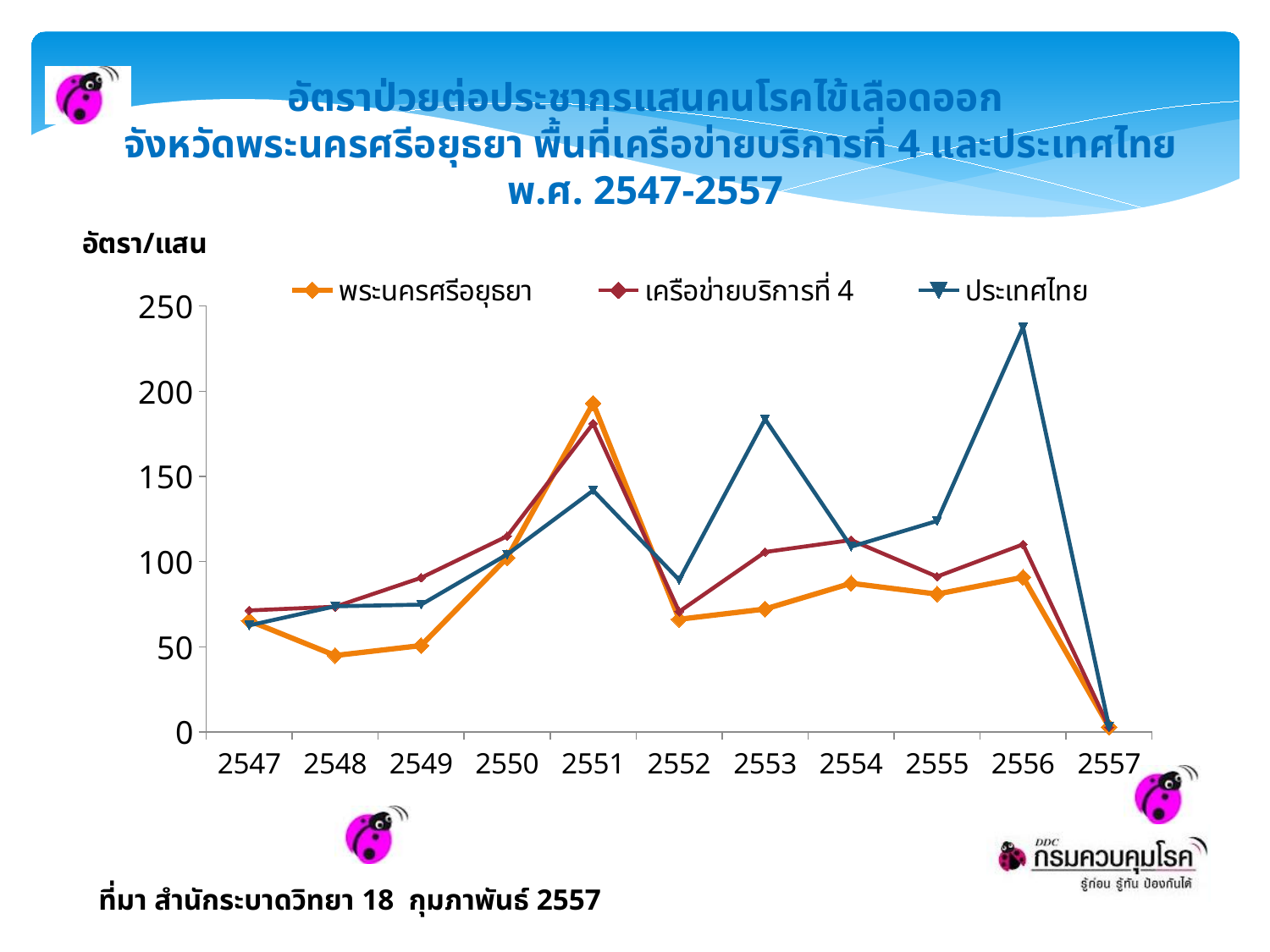
Is the value for ประเทศไทย in 2553 greater or less than 150? greater Do the values for all three series rise or fall from 2556 to 2557? fall What label is shown above the y axis? อัตรา/แสน In 2551, which series has the higher value: พระนครศรีอยุธยา or ประเทศไทย? พระนครศรีอยุธยา In which year does the พระนครศรีอยุธยา series reach its highest value? 2551 Is the value for ประเทศไทย in 2556 greater or less than 200? greater Is the value for พระนครศรีอยุธยา in 2548 greater or less than 50? less How many series does the legend list? 3 How many years are shown along the x axis? 11 In 2553, which series has the higher value: ประเทศไทย or เครือข่ายบริการที่ 4? ประเทศไทย What kind of chart is shown on the slide? line chart In which year does the ประเทศไทย series reach its highest value? 2556